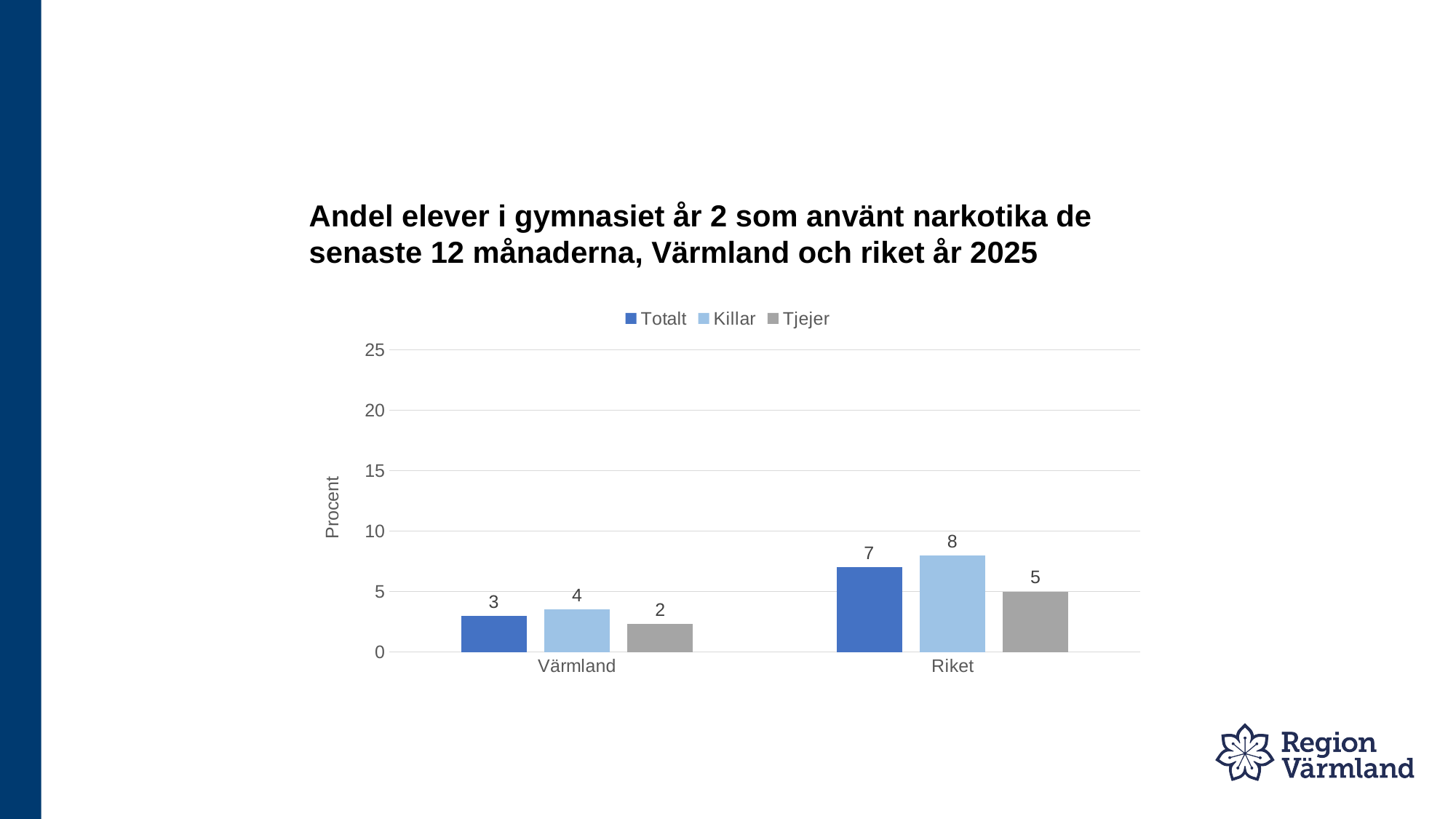
What is the difference between the Totalt value for Riket and the Totalt value for Värmland? 4 What is the value for Tjejer in Riket? 5 What kind of chart is shown on the slide? Bar chart How many categories are shown on the x axis? 2 Which is larger, the Killar value for Värmland or the Killar value for Riket? Riket Which series has the highest value in Riket? Killar How many series does the legend list? 3 Which series has the lowest value in Värmland? Tjejer What is the value for Killar in Riket? 8 What is the label of the y axis? Procent What is the value for Tjejer in Värmland? 2 What is the value for Totalt in Värmland? 3